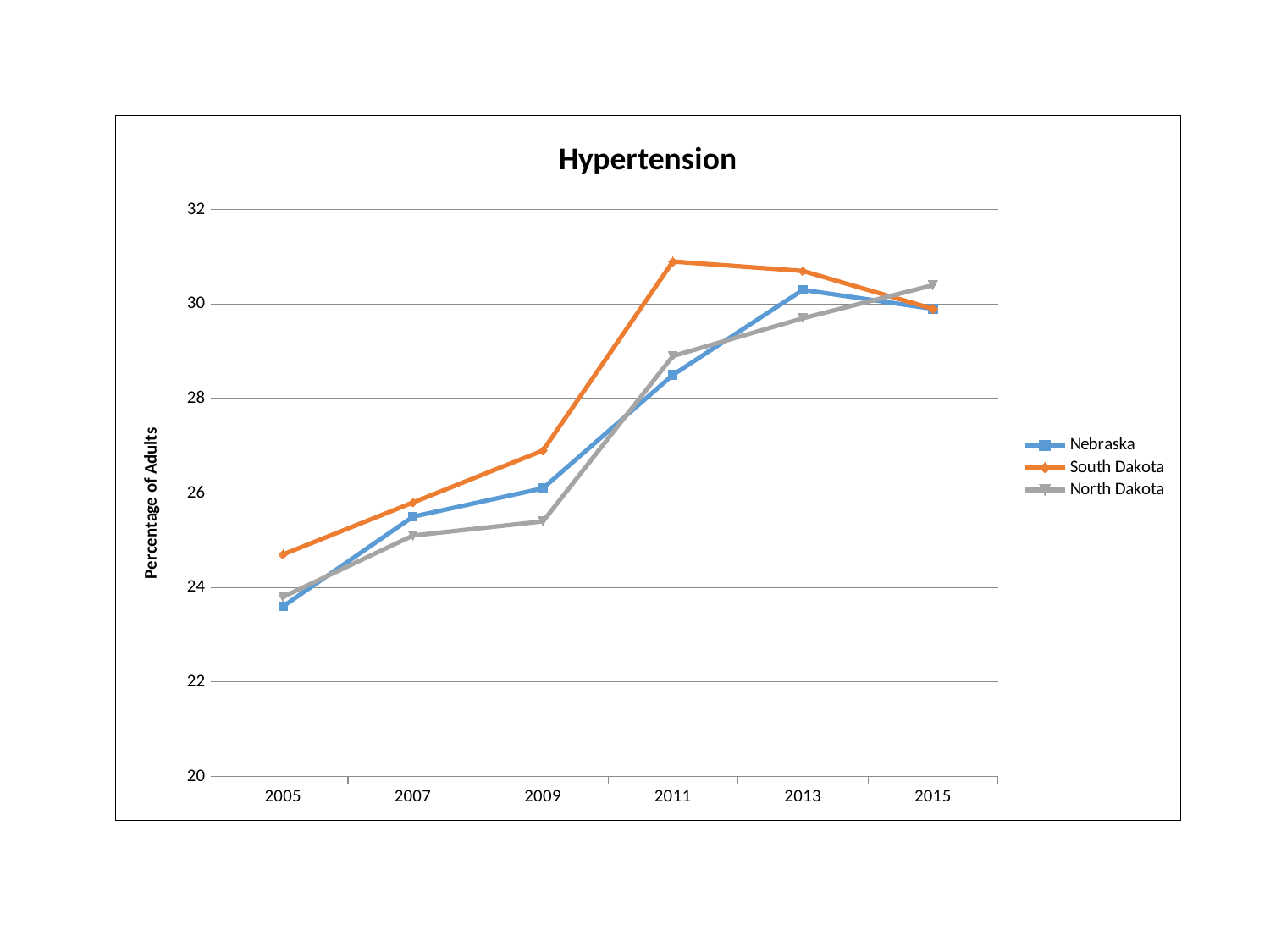
What is the label on the vertical axis? Percentage of Adults In which year does South Dakota reach its highest value? 2011 Is the value for North Dakota in 2009 greater or less than 26? less What kind of chart is shown on the slide? line chart In which year is Nebraska's value lowest? 2005 Is the value for South Dakota in 2011 greater or less than 30? greater How many years are plotted along the x axis? 6 Does the Nebraska line rise or fall from 2005 to 2013? rise In 2015, which is larger: the value for North Dakota or the value for South Dakota? North Dakota In 2011, which is larger: the value for South Dakota or the value for Nebraska? South Dakota Is the value for Nebraska in 2005 greater or less than 24? less How many series does the legend list? 3